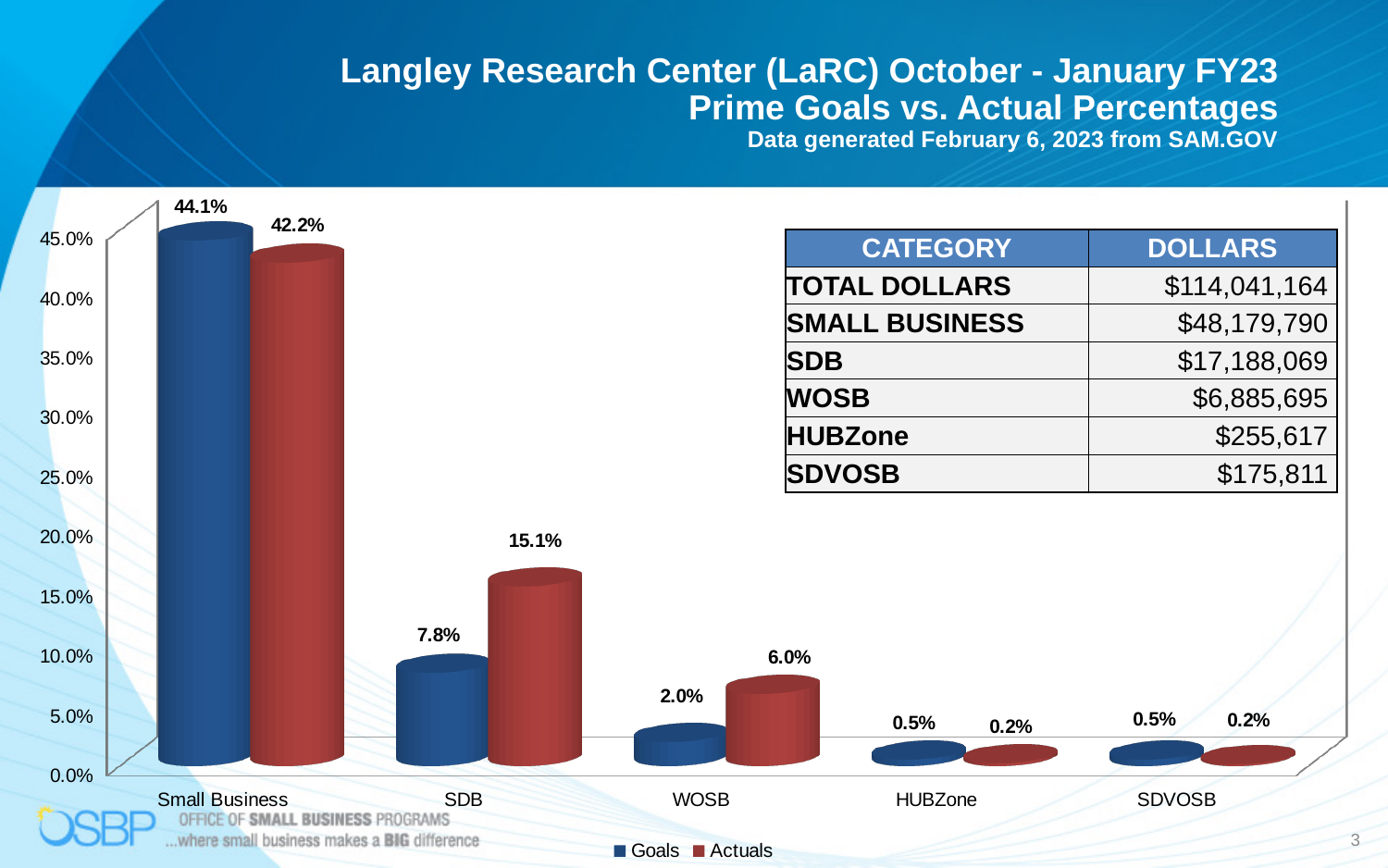
What is the difference between the Goals and Actuals values for SDB? 7.3% What is the Goals value for Small Business? 44.1% How many categories are shown on the x axis? 5 Which colour represents the Actuals series in the chart? Red Which is larger for WOSB, the Goals value or the Actuals value? Actuals What is the difference between the Goals and Actuals values for Small Business? 1.9% What is the Actuals value for SDB? 15.1% What kind of chart is shown on the slide? Bar chart How many series does the legend list? 2 What is the Actuals value for WOSB? 6.0% What is the Goals value for HUBZone? 0.5% Which category has the highest Actuals value? Small Business